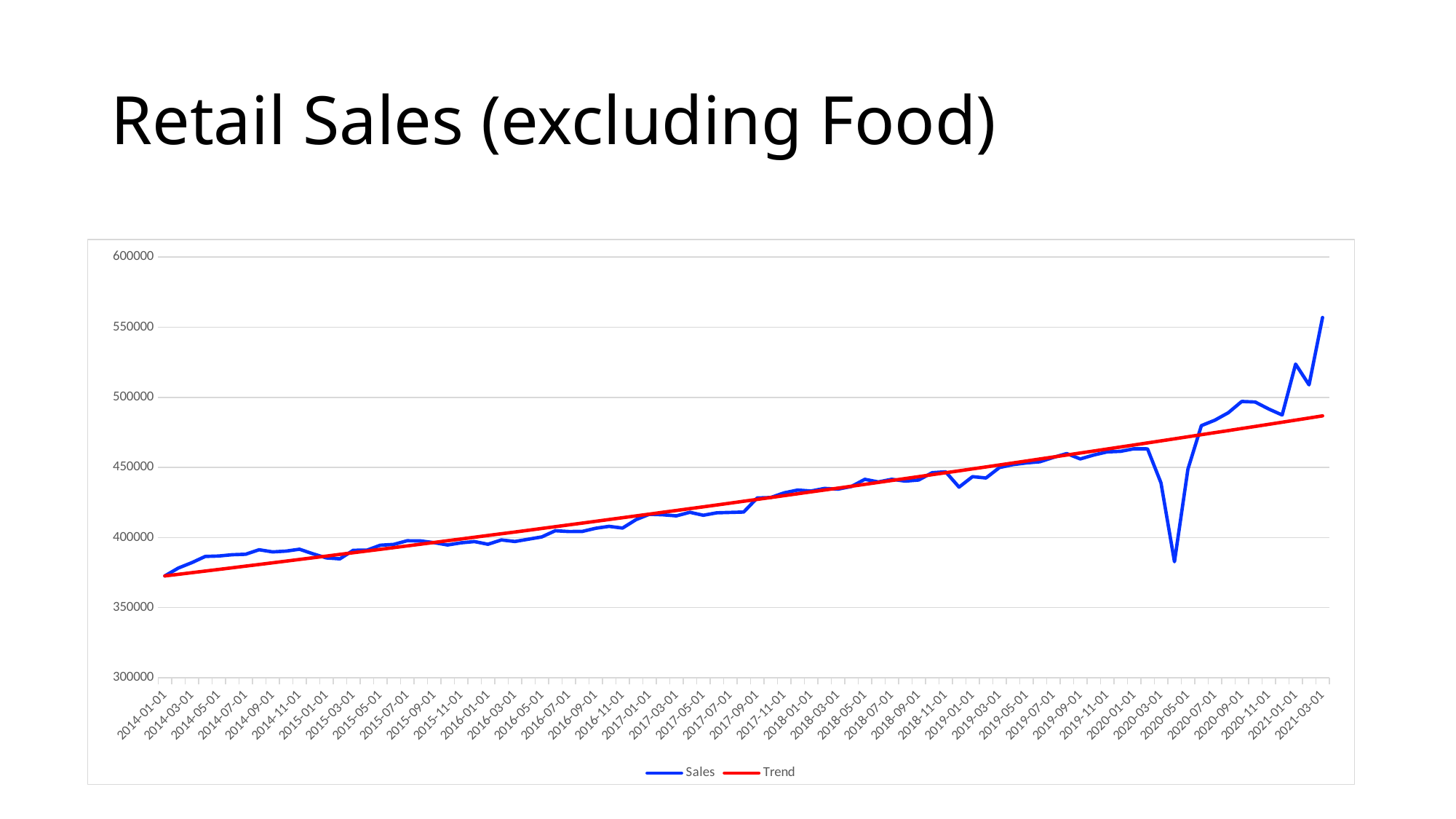
At which date does the Sales series reach its highest value? 2021-03-01 At 2020-05-01, which series has the larger value, Sales or Trend? Trend Is the Sales value at 2021-03-01 greater or less than 500000? greater Do the Sales values generally rise or fall from 2014-01-01 to 2021-03-01? rise At 2021-03-01, which series has the larger value, Sales or Trend? Sales What are the two series named in the legend? Sales and Trend Is the Trend value at 2021-03-01 greater or less than 500000? less Is the Sales value at 2020-05-01 greater or less than 400000? greater What kind of chart is shown on the slide? line chart What is the title of the slide containing the chart? Retail Sales (excluding Food) How many series does the legend list? 2